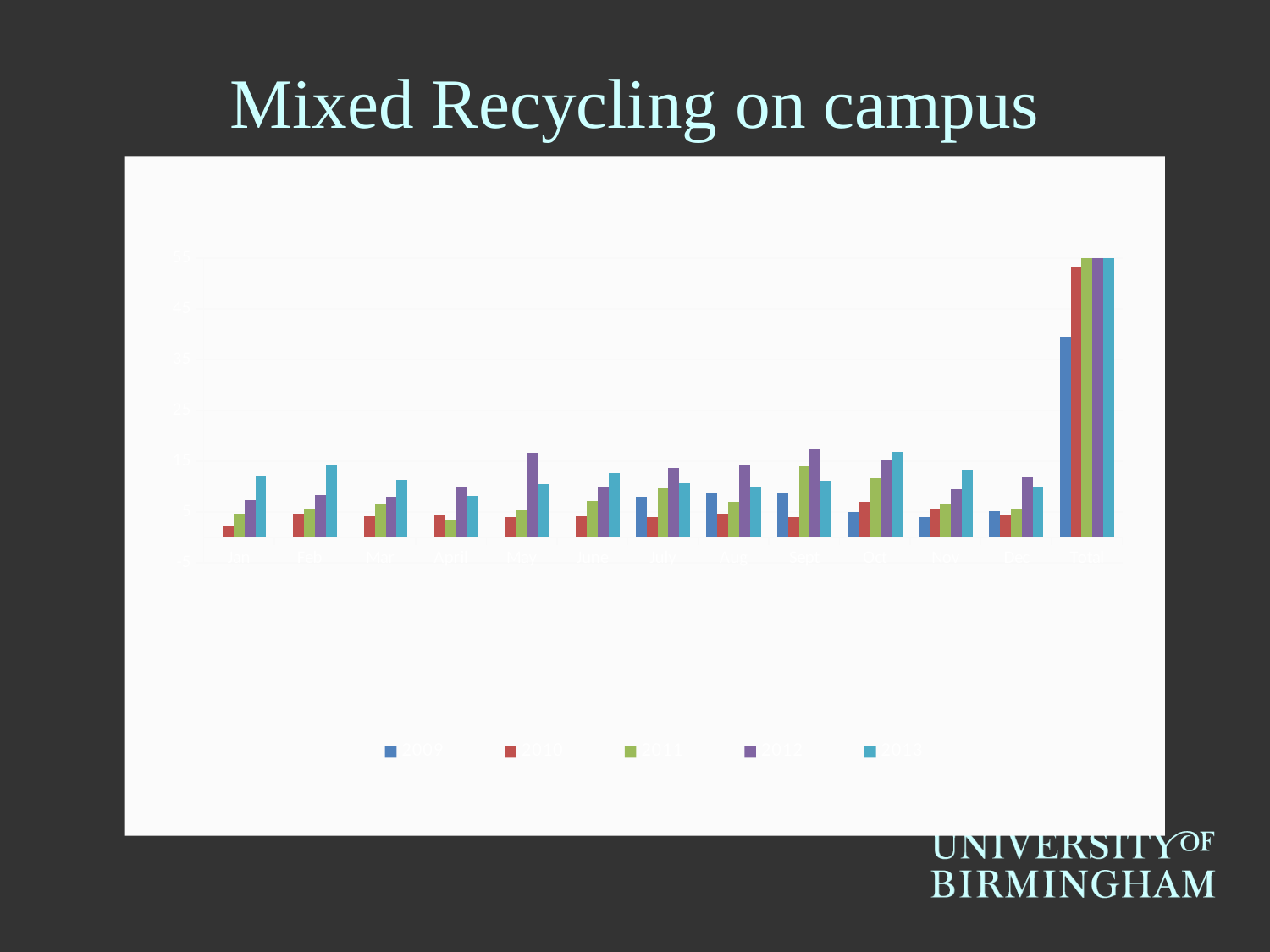
How many series does the legend list? 5 What is the title of the slide containing the chart? Mixed Recycling on campus How many categories are shown along the x axis? 13 Which years are listed in the chart's legend? 2009, 2010, 2011, 2012, 2013 Which category has the tallest bars in the chart? Total What kind of chart is shown on the slide? bar chart Within the Total category, which series has the shortest bar? 2009 Is the 2013 bar for Total larger or smaller than the 2013 bar for Jan? larger